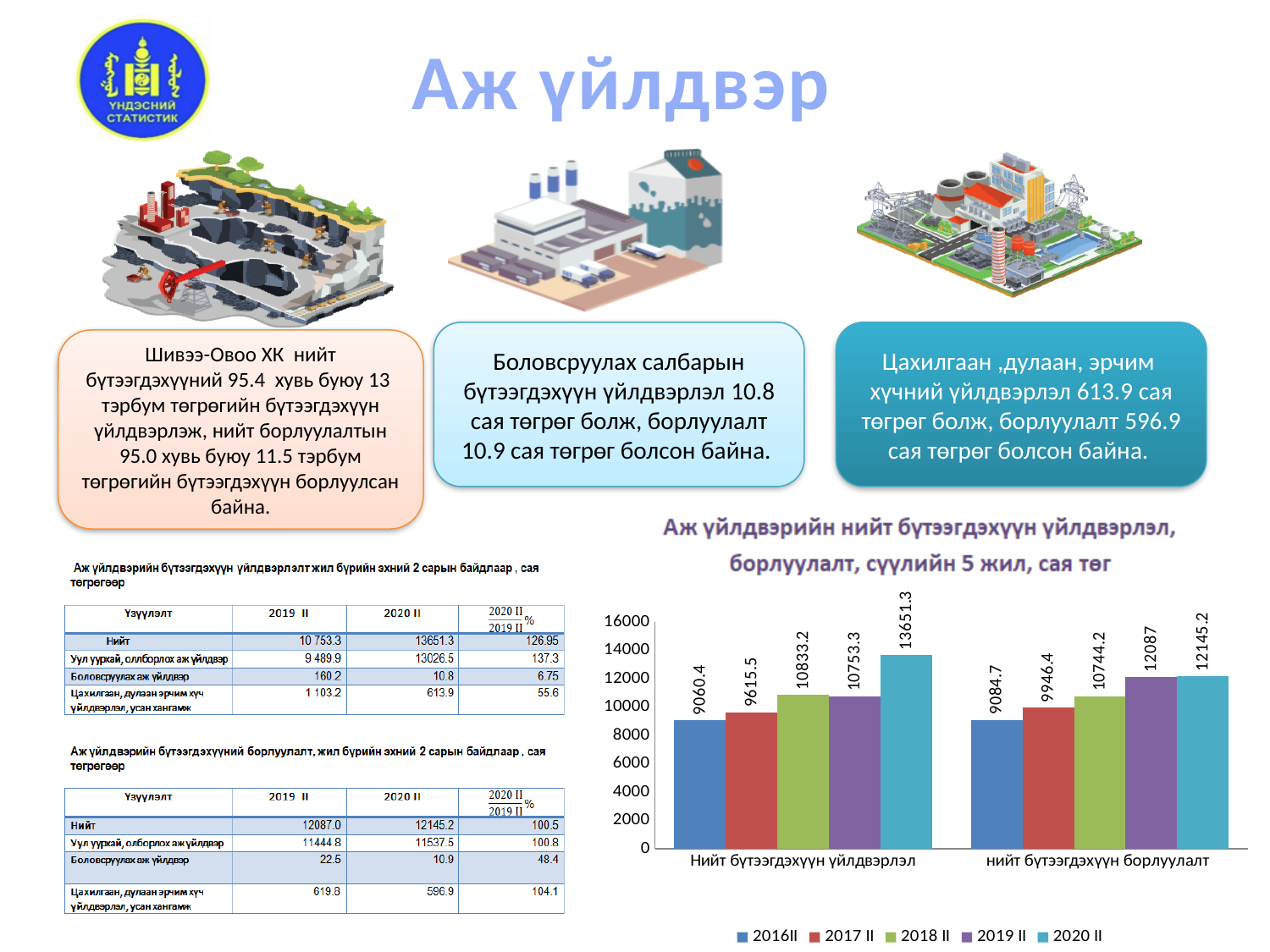
Is the 2017 II value for нийт бүтээгдэхүүн борлуулалт greater or less than 10000? less What is the title of the chart? Аж үйлдвэрийн нийт бүтээгдэхүүн үйлдвэрлэл, борлуулалт, сүүлийн 5 жил, сая төг What is the difference between the 2020 II and 2019 II values in the category Нийт бүтээгдэхүүн үйлдвэрлэл? 2898 Which series has the lowest value in the category нийт бүтээгдэхүүн борлуулалт? 2016II What type of chart is shown on the slide? bar chart What is the value for 2016II in the category Нийт бүтээгдэхүүн үйлдвэрлэл? 9060.4 What is the value for 2019 II in the category нийт бүтээгдэхүүн борлуулалт? 12087 What is the value for 2020 II in the category Нийт бүтээгдэхүүн үйлдвэрлэл? 13651.3 How many series does the chart legend list? 5 Which is larger: the 2018 II value for Нийт бүтээгдэхүүн үйлдвэрлэл or the 2018 II value for нийт бүтээгдэхүүн борлуулалт? Нийт бүтээгдэхүүн үйлдвэрлэл How many categories are shown on the x axis of the chart? 2 Which series has the highest value in the category Нийт бүтээгдэхүүн үйлдвэрлэл? 2020 II